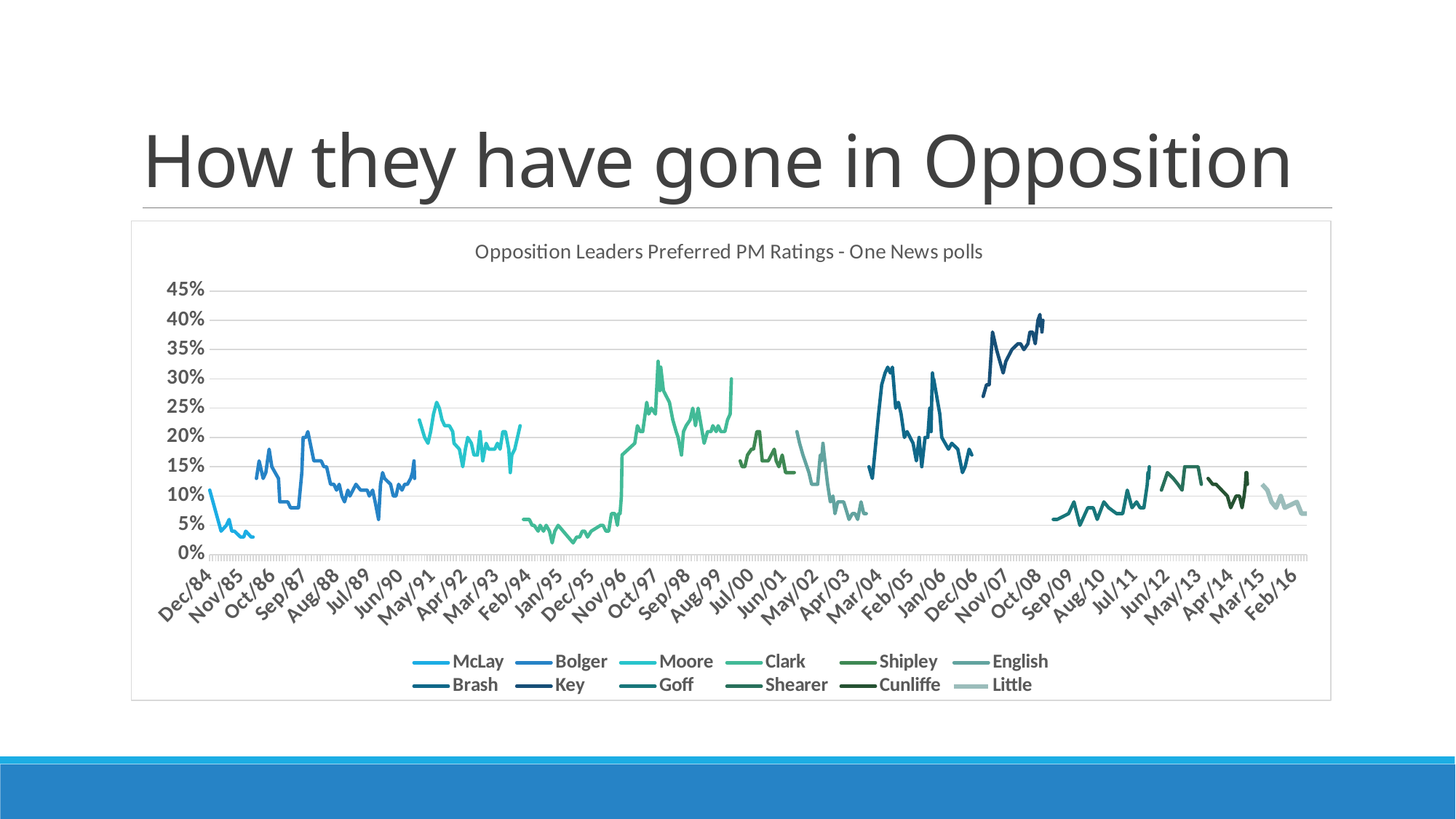
Are all values of the Goff line greater or less than 20%? less Is the peak value of the Brash line greater or less than 25%? greater What is the title of the chart? Opposition Leaders Preferred PM Ratings - One News polls Which leader's line reaches the highest preferred PM rating on the chart? Key Is the peak value of the Key line greater or less than 35%? greater What kind of chart is shown on the slide? line chart How many series does the legend list? 12 Does the McLay line generally rise or fall over its time span? fall Does the Key line generally rise or fall over its time span? rise Which line reaches a higher peak, Key or Goff? Key